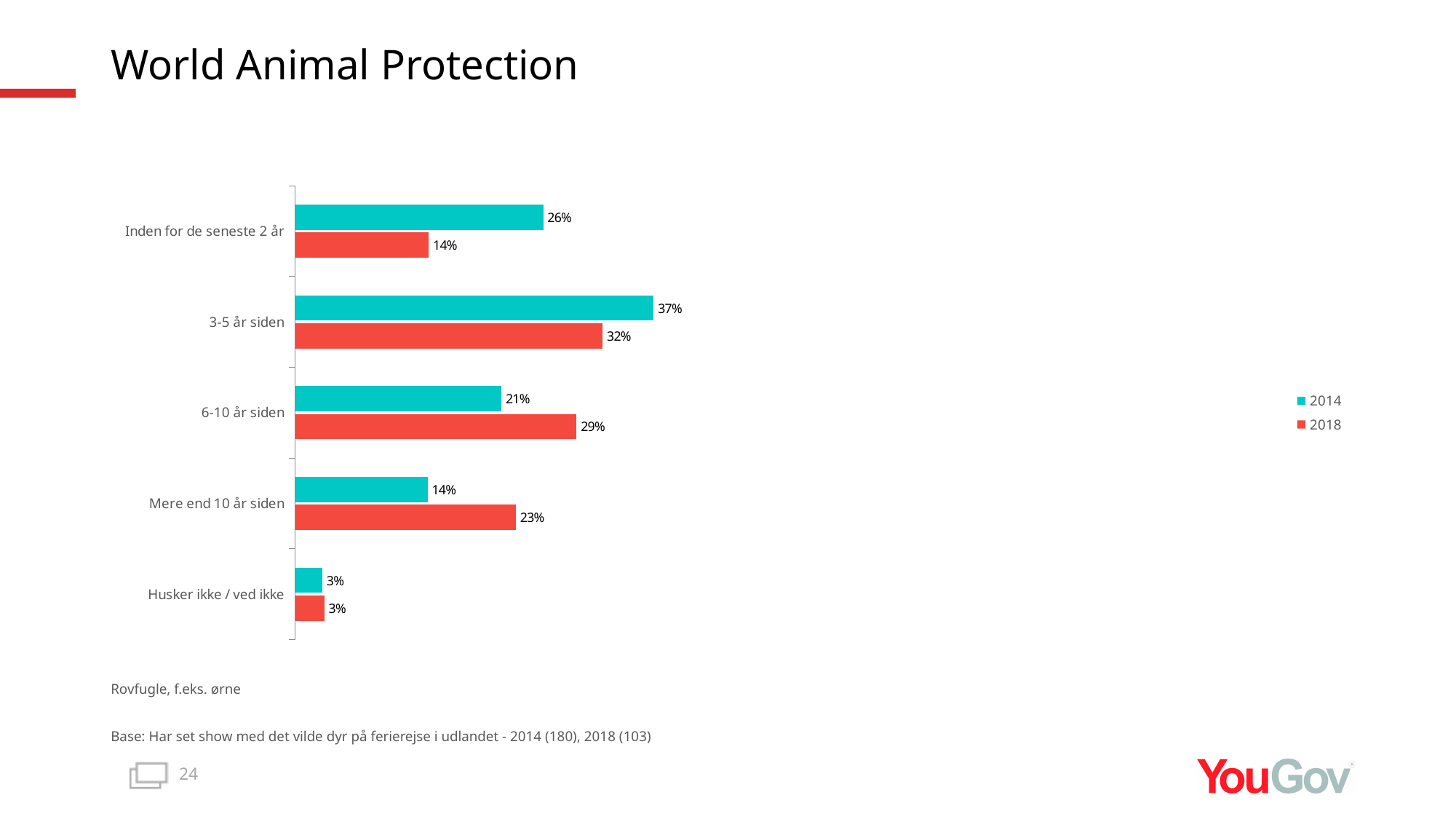
What kind of chart is shown on the slide? Bar chart Which colour represents the 2018 series? Red How many categories are shown on the chart? 5 Which category has the lowest 2014 value? Husker ikke / ved ikke What is the 2018 value for "6-10 år siden"? 29% What is the 2014 value for "3-5 år siden"? 37% Which category has the highest 2018 value? 3-5 år siden How many series does the legend list? 2 Which is larger for "Mere end 10 år siden": the 2014 value or the 2018 value? 2018 What is the difference between the 2014 and 2018 values for "Inden for de seneste 2 år"? 12% What is the 2018 value for "Inden for de seneste 2 år"? 14% What is the difference between the 2014 and 2018 values for "6-10 år siden"? 8%